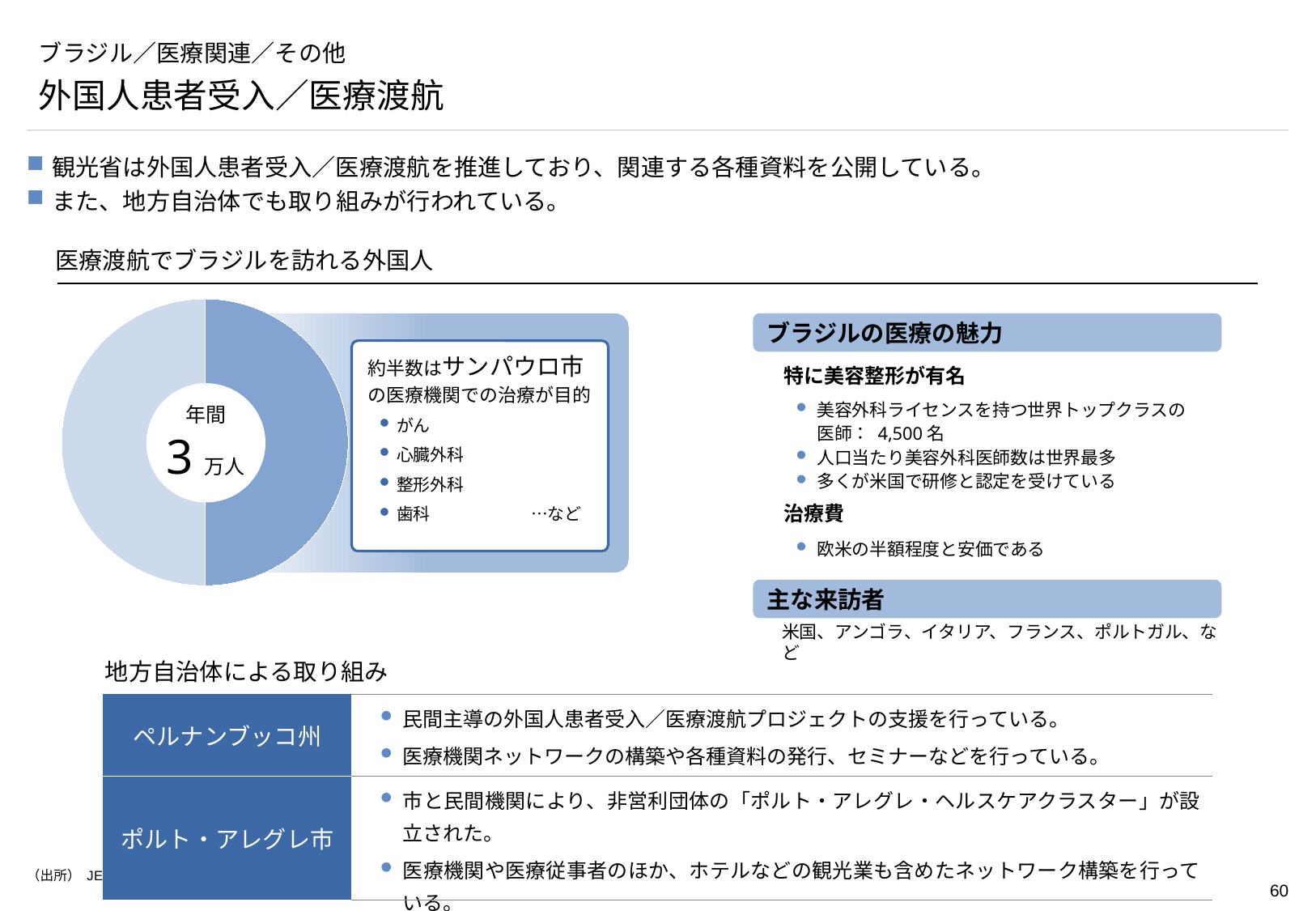
How many slices does the donut chart have? 2 What kind of chart is shown under the heading 医療渡航でブラジルを訪れる外国人? Pie (donut) chart What is the title of the section containing the donut chart? 医療渡航でブラジルを訪れる外国人 According to the callout next to the donut chart, what does the highlighted (darker) half of the chart represent? 約半数はサンパウロ市の医療機関での治療が目的 What annual number of foreign medical travelers is printed in the center of the donut chart? 3万人